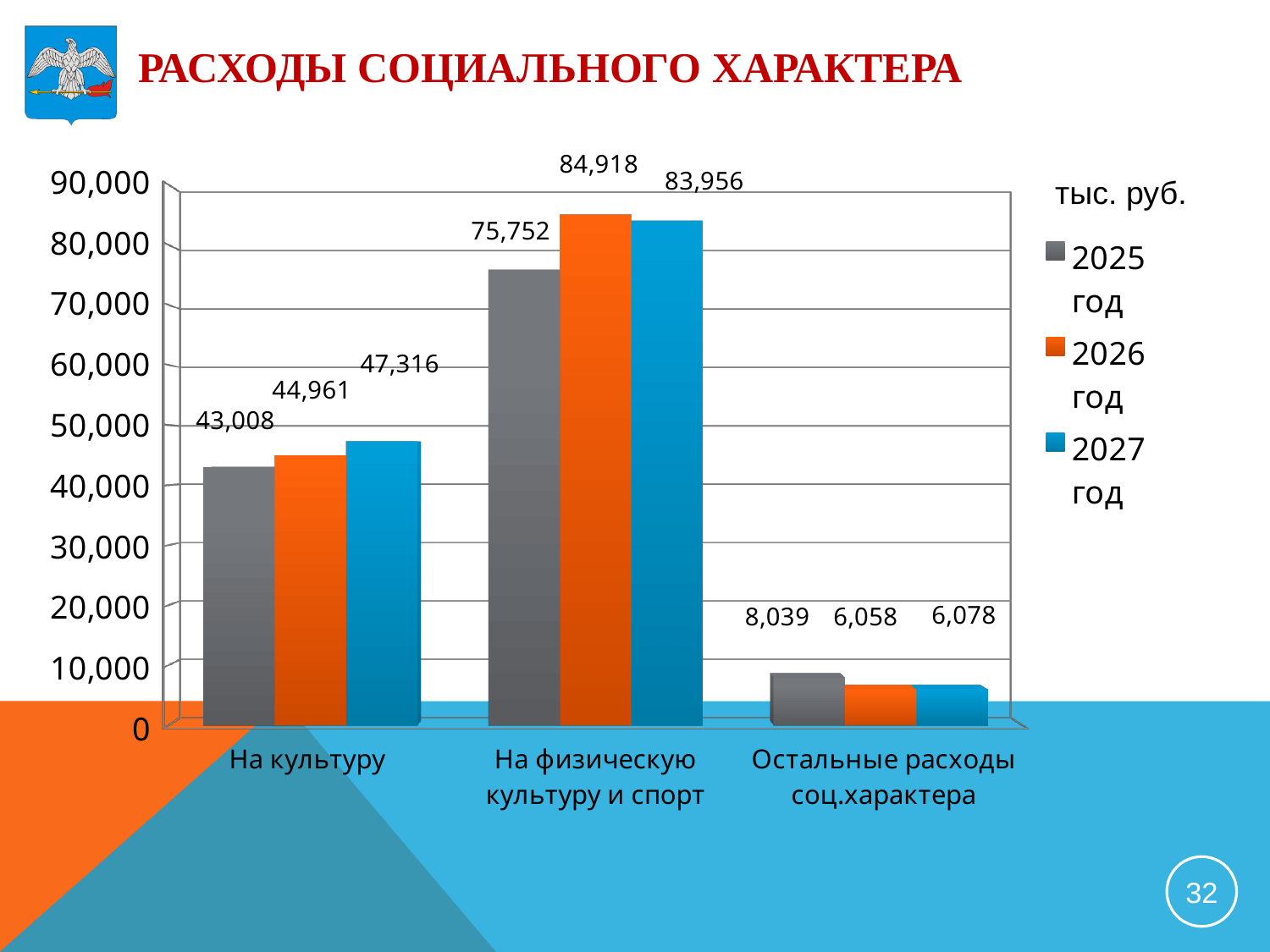
What unit is indicated next to the legend? тыс. руб. Which category has the highest value in 2027 год? На физическую культуру и спорт How many series does the legend list? 3 Is the 2025 год value for "На физическую культуру и спорт" greater or less than 70,000? greater What is the value for "На физическую культуру и спорт" in 2026 год? 84,918 Which is larger for "На физическую культуру и спорт": the 2026 год value or the 2027 год value? 2026 год What is the difference between the 2027 год and 2025 год values for "На культуру"? 4,308 Which category has the lowest value in 2025 год? Остальные расходы соц.характера What is the value for "Остальные расходы соц.характера" in 2027 год? 6,078 What kind of chart is shown on the slide? bar chart How many categories are shown on the x axis? 3 What is the value for "На культуру" in 2025 год? 43,008